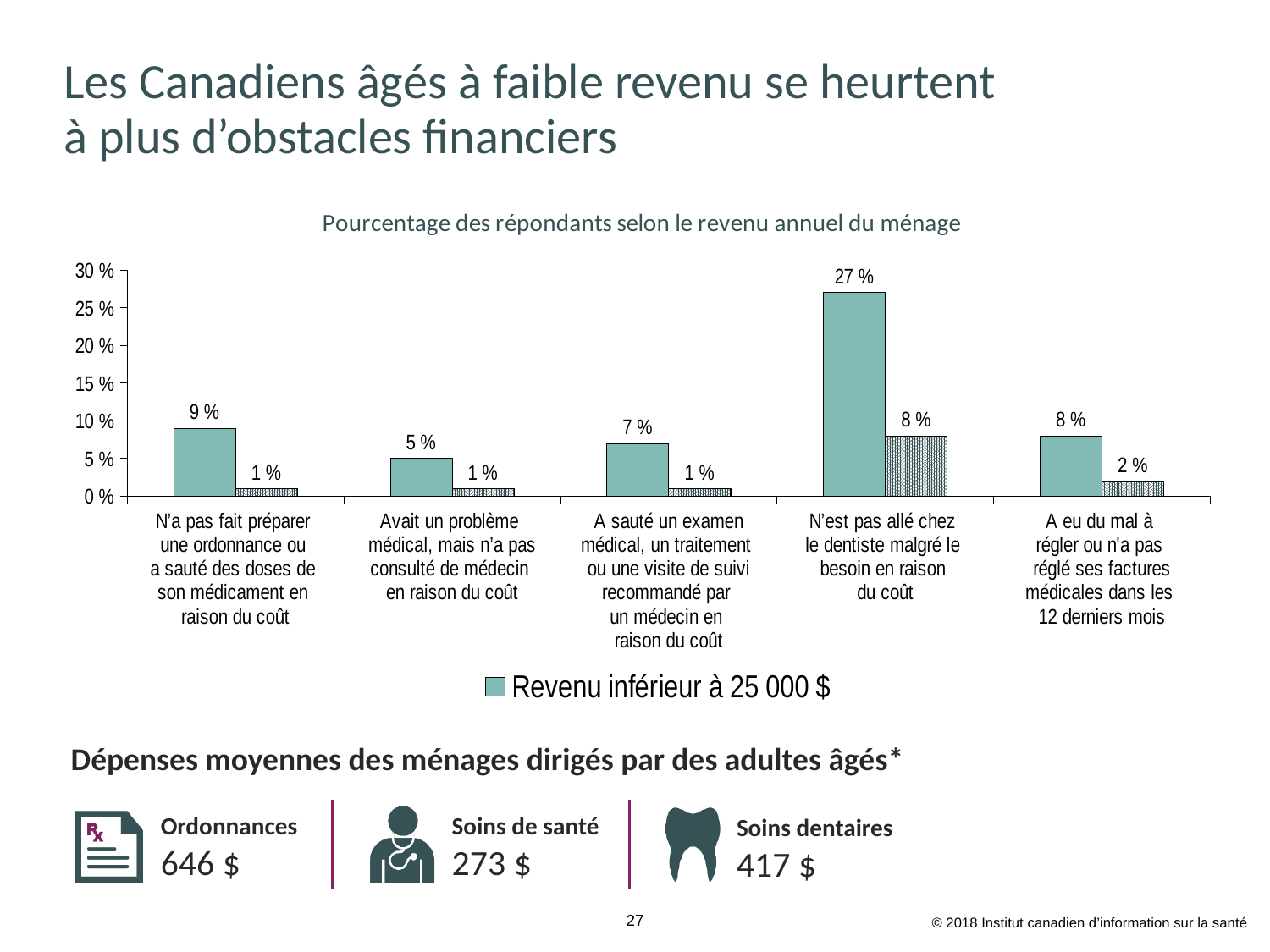
What kind of chart is shown on the slide? bar chart Which category has the lowest value for 'Revenu inférieur à 25 000 $'? Avait un problème médical, mais n'a pas consulté de médecin en raison du coût What is the value for 'Revenu inférieur à 25 000 $' in the category 'N'est pas allé chez le dentiste malgré le besoin en raison du coût'? 27 % What is the title of the chart? Pourcentage des répondants selon le revenu annuel du ménage Is the value for 'Revenu inférieur à 25 000 $' in the dentist category greater or less than 25 %? greater What is the value of the teal bar for 'N'a pas fait préparer une ordonnance ou a sauté des doses de son médicament en raison du coût'? 9 % Which is larger for 'Revenu inférieur à 25 000 $': the value for 'A sauté un examen médical...' or the value for 'A eu du mal à régler ou n'a pas réglé ses factures médicales...'? A eu du mal à régler ou n'a pas réglé ses factures médicales dans les 12 derniers mois How many categories are shown on the x axis of the chart? 5 What is the value of the teal bar for 'Avait un problème médical, mais n'a pas consulté de médecin en raison du coût'? 5 % Which category has the highest value for 'Revenu inférieur à 25 000 $'? N'est pas allé chez le dentiste malgré le besoin en raison du coût What is the value of the patterned bar for 'A eu du mal à régler ou n'a pas réglé ses factures médicales dans les 12 derniers mois'? 2 % What is the difference between the two bars in the category 'N'est pas allé chez le dentiste malgré le besoin en raison du coût'? 19 %